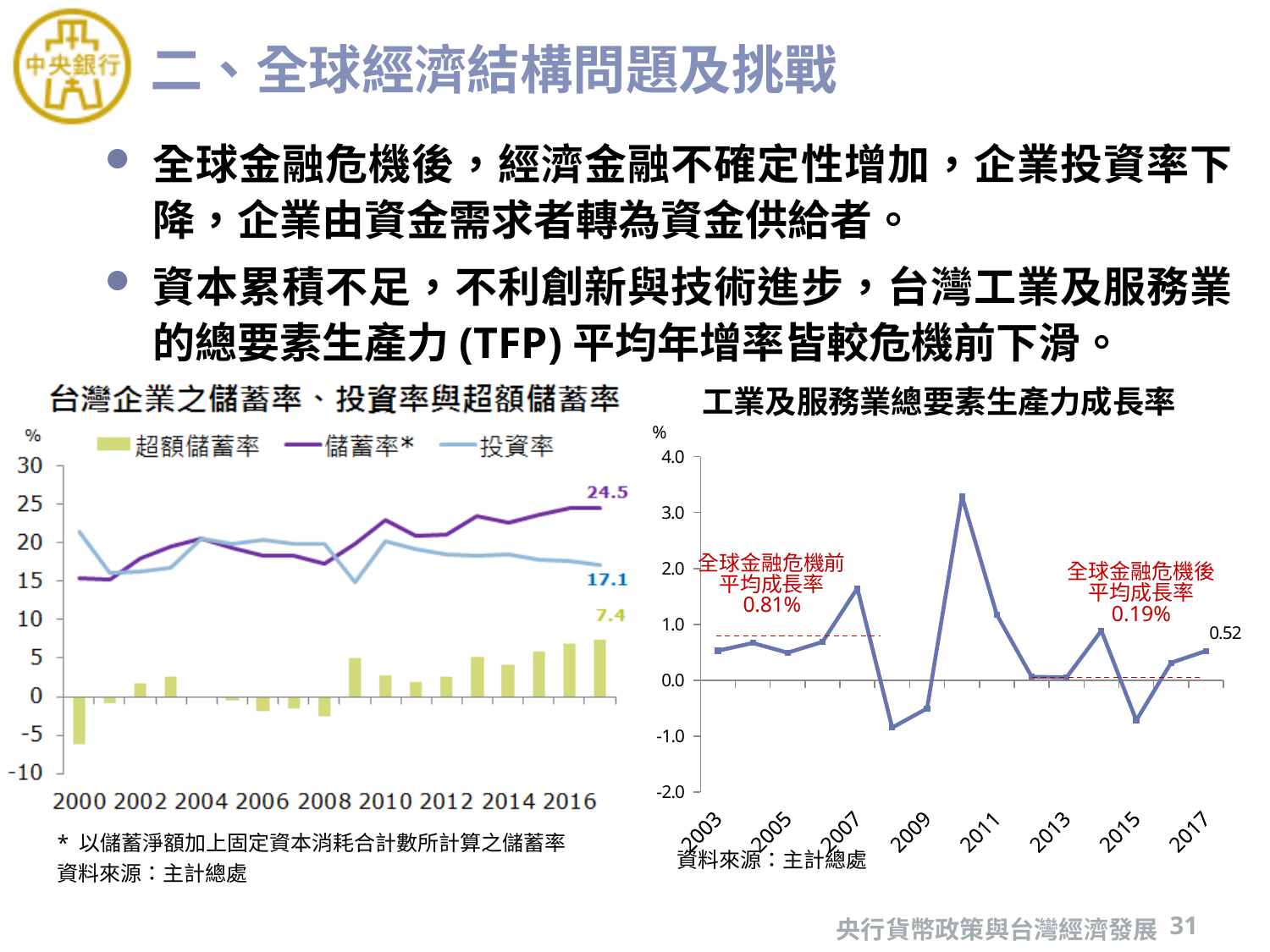
In the right chart (工業及服務業總要素生產力成長率), what is the labelled value for 2017? 0.52 In the left chart (台灣企業之儲蓄率、投資率與超額儲蓄率), which is larger at the final data point, 儲蓄率* or 投資率? 儲蓄率* In the right chart (工業及服務業總要素生產力成長率), which year has the highest growth rate? 2010 In the right chart (工業及服務業總要素生產力成長率), is the value for 2010 greater or less than 3.0? greater In the left chart (台灣企業之儲蓄率、投資率與超額儲蓄率), what is the labelled value of 儲蓄率* at the final data point? 24.5 In the right chart (工業及服務業總要素生產力成長率), what is the annotated average growth rate after the global financial crisis (全球金融危機後平均成長率)? 0.19% In the left chart (台灣企業之儲蓄率、投資率與超額儲蓄率), how many series does the legend list? 3 In the left chart (台灣企業之儲蓄率、投資率與超額儲蓄率), what is the labelled value of 投資率 at the final data point? 17.1 In the left chart (台灣企業之儲蓄率、投資率與超額儲蓄率), is the 超額儲蓄率 bar for 2000 greater or less than 0? less In the left chart (台灣企業之儲蓄率、投資率與超額儲蓄率), what is the labelled value of 超額儲蓄率 at the final data point? 7.4 What kind of chart is the right chart (工業及服務業總要素生產力成長率)? line chart In the left chart (台灣企業之儲蓄率、投資率與超額儲蓄率), what is the difference between the final labelled values of 儲蓄率* and 投資率? 7.4